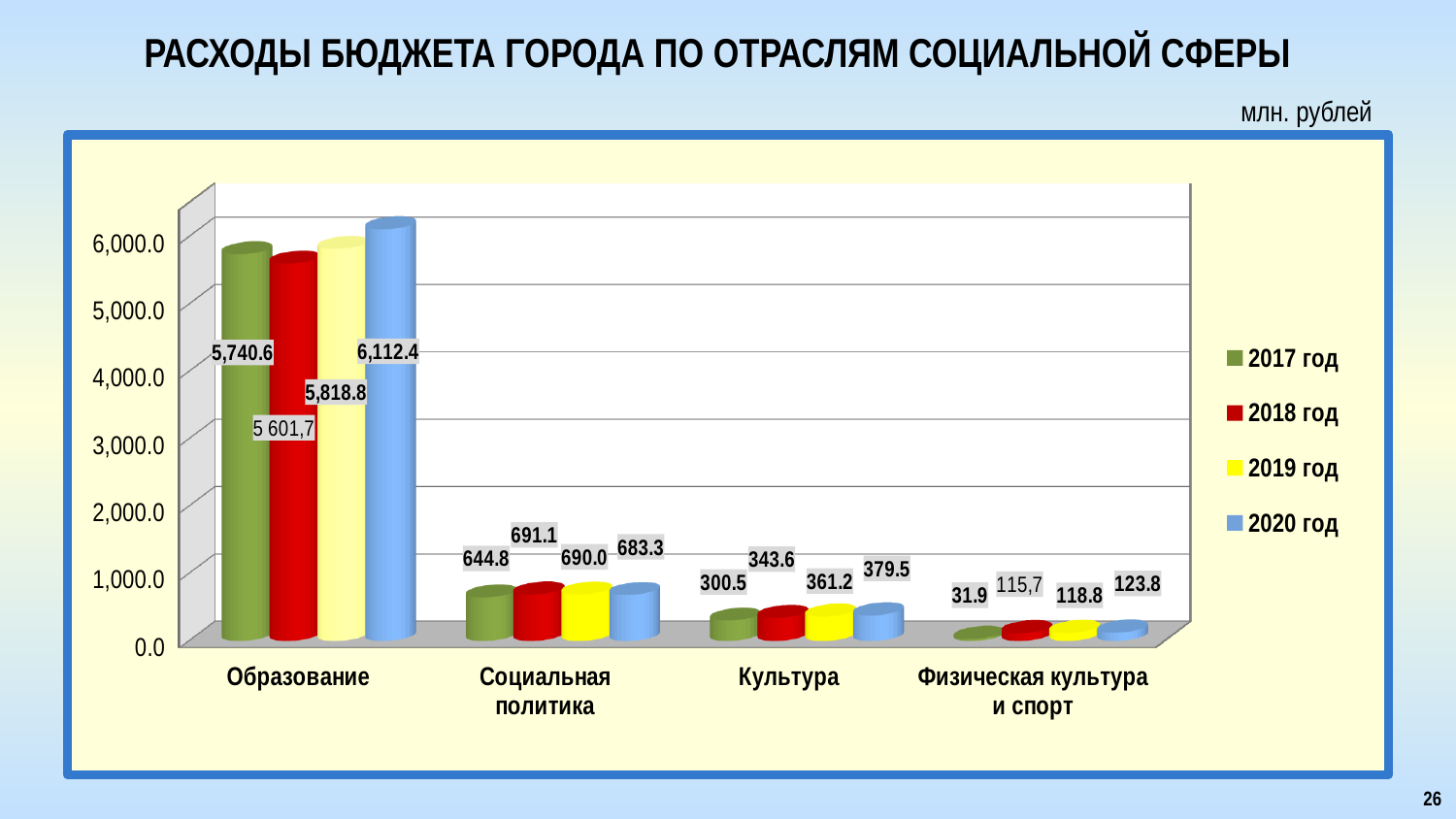
What unit of measurement is stated above the chart? млн. рублей Which category has the highest value in 2020 год? Образование What is the value for Физическая культура и спорт in 2019 год? 118.8 How many categories are shown on the x axis? 4 What is the value for Социальная политика in 2018 год? 691.1 What is the value for Культура in 2017 год? 300.5 What is the value for Образование in 2020 год? 6,112.4 Which is larger for Культура: the 2019 год value or the 2020 год value? 2020 год What kind of chart is shown on the slide? Bar chart How many series does the legend list? 4 Which category has the lowest value in 2017 год? Физическая культура и спорт What is the difference between the 2020 год and 2017 год values for Образование? 371.8